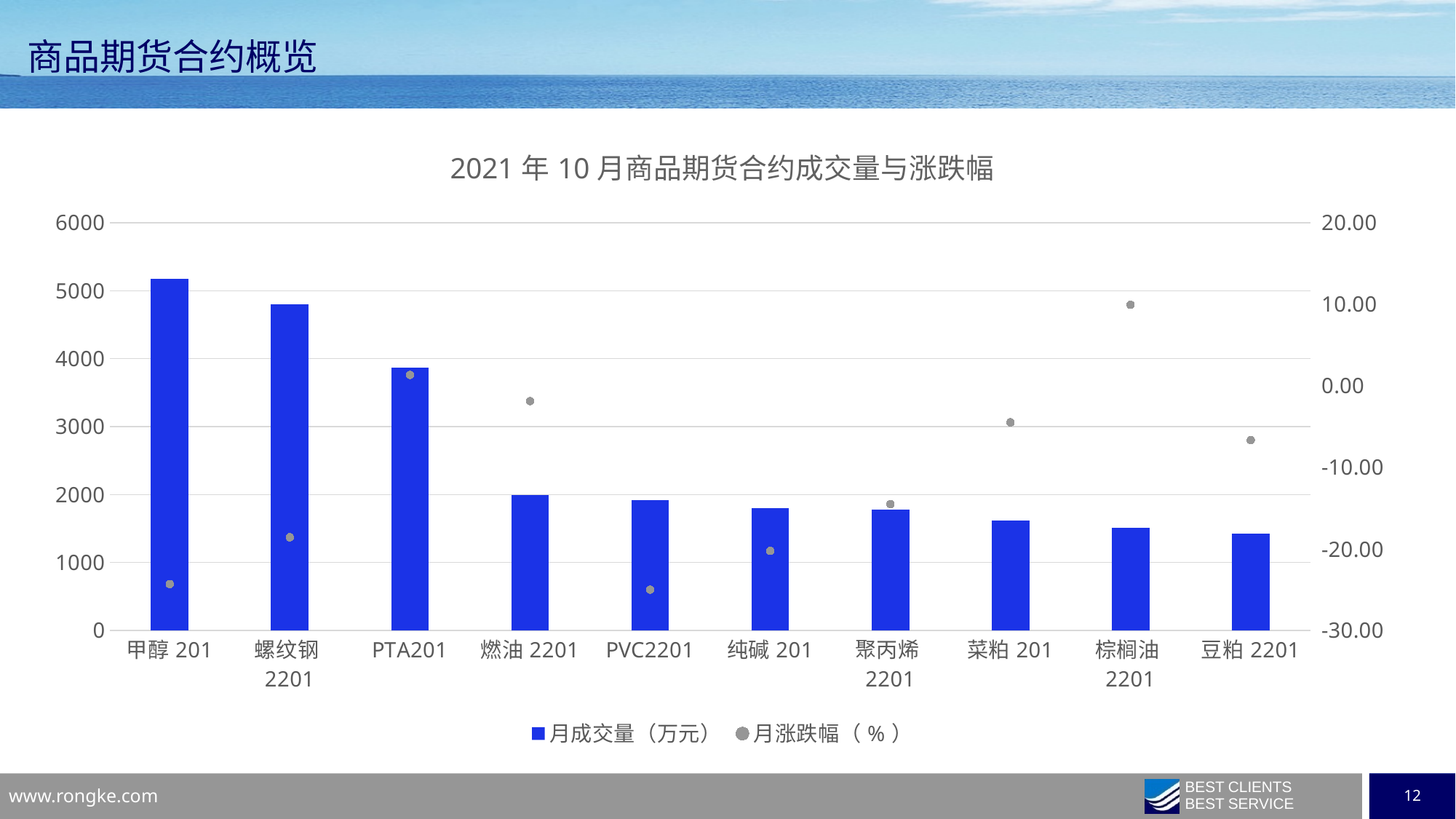
Which contract has the lowest 月成交量 (bar)? 豆粕 2201 Is the 月成交量 for 甲醇 201 greater or less than 5000? greater Is the 月成交量 for 燃油 2201 greater or less than 3000? less How many contract categories are shown on the x axis? 10 Which contract has the highest 月涨跌幅 (dot)? 棕榈油 2201 How many series does the legend list? 2 What is the title of the chart? 2021 年 10 月商品期货合约成交量与涨跌幅 Is the 月涨跌幅 for 甲醇 201 greater or less than -20.00? less What kind of chart is shown on the slide? A combined bar and scatter (dot) chart Do the 月成交量 bars generally rise or fall from left to right along the x axis? fall Which has a larger 月成交量, 甲醇 201 or 螺纹钢 2201? 甲醇 201 Which contract has the highest 月成交量 (bar)? 甲醇 201